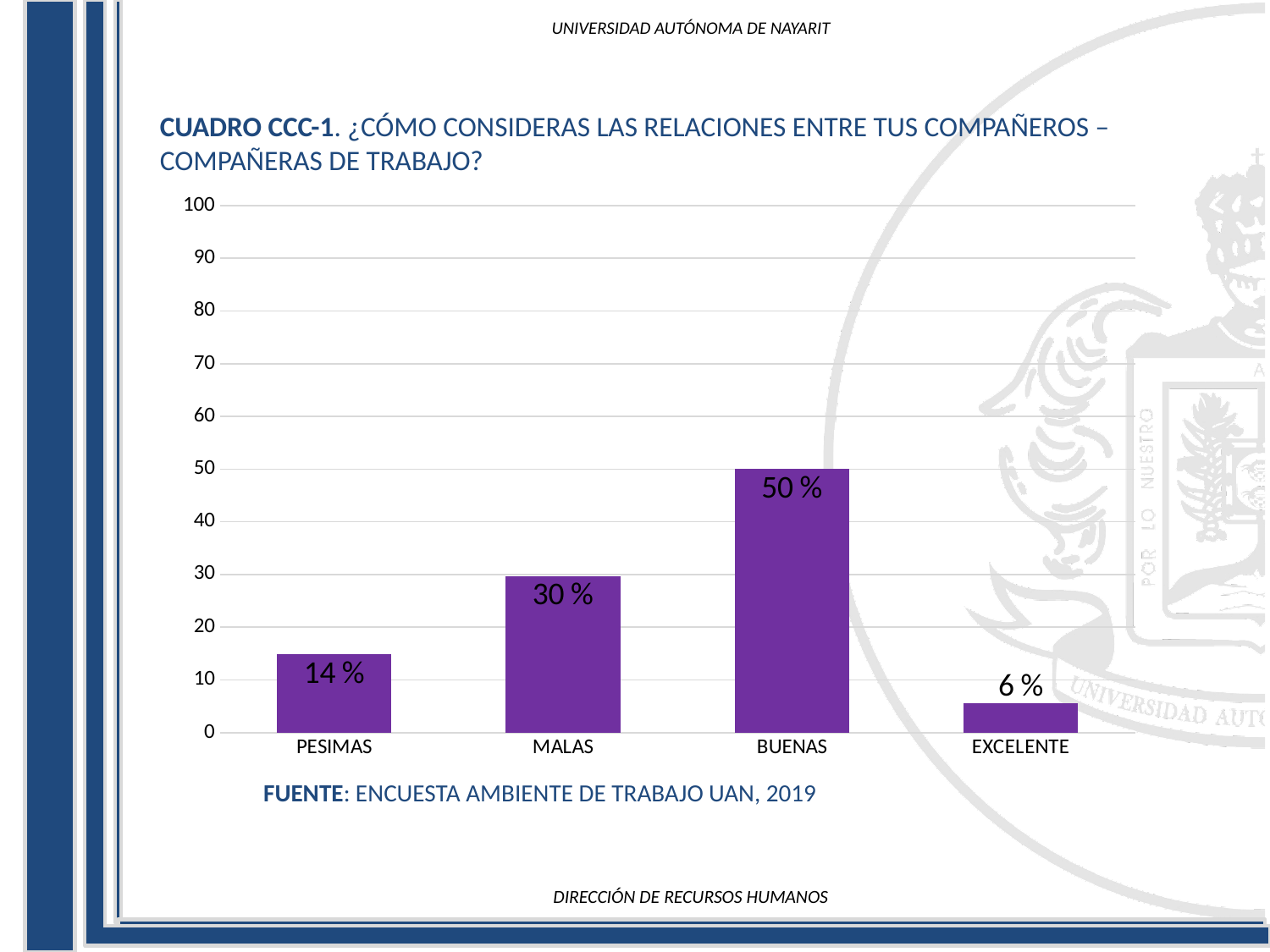
What kind of chart is shown on the slide? bar chart What is the value for MALAS? 30 % What is the value for BUENAS? 50 % What is the value for EXCELENTE? 6 % What is the difference between the values for BUENAS and MALAS? 20 % How many categories are shown on the x axis? 4 What is the value for PESIMAS? 14 % What source is cited below the chart? ENCUESTA AMBIENTE DE TRABAJO UAN, 2019 Which category has the lowest value? EXCELENTE Which category has the highest value? BUENAS Which is larger, the value for PESIMAS or the value for EXCELENTE? PESIMAS Is the value for MALAS greater or less than 20? greater